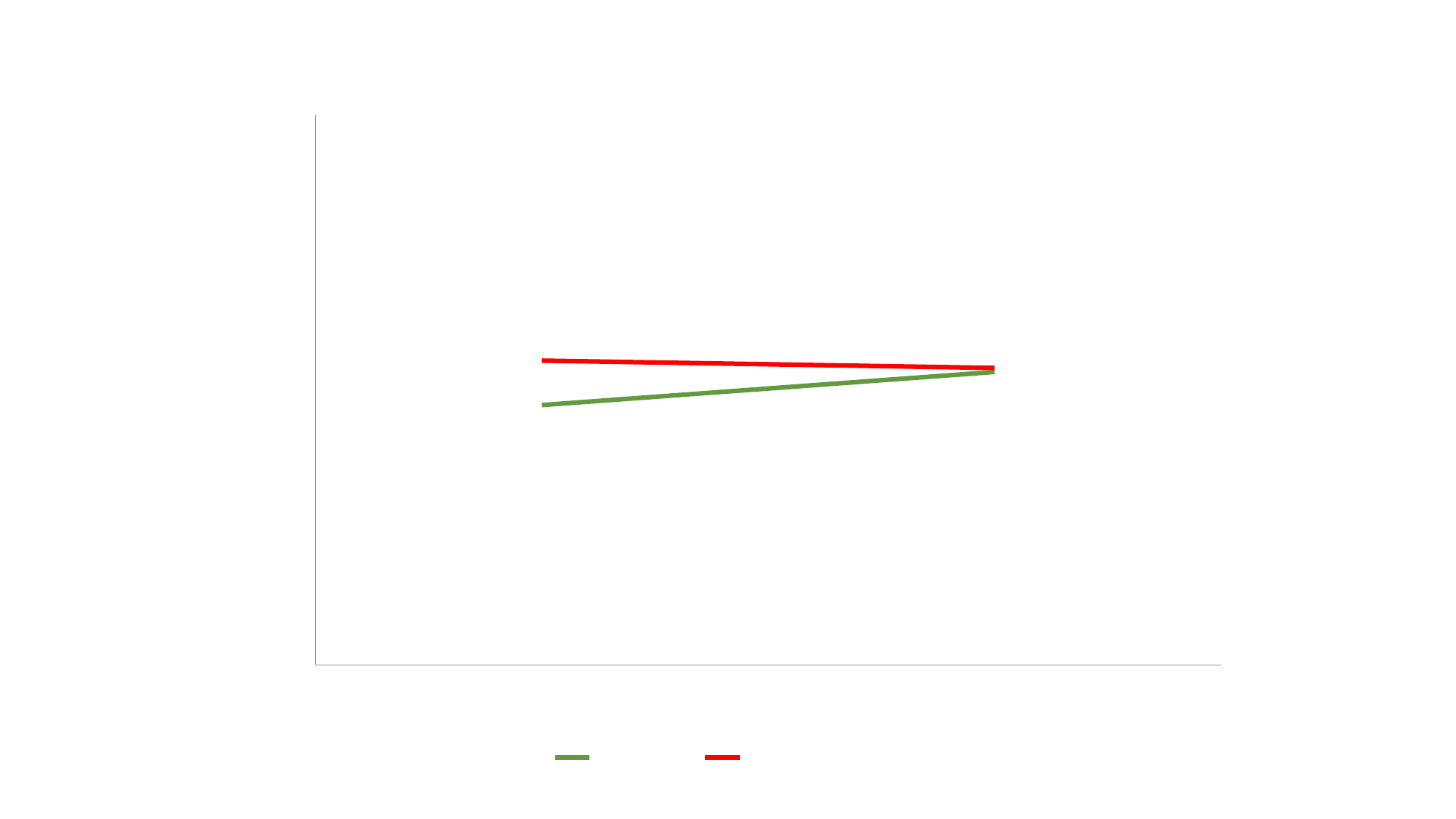
Does the green line rise or fall from left to right? rise How many lines are plotted on the chart? 2 Where is the legend positioned relative to the plot area? below the plot area What colours are the two lines on the chart? green and red Does the red line rise or fall from left to right? fall How many series does the legend list? 2 At the left end of the lines, which is higher, the green line or the red line? the red line What kind of chart is shown on the slide? line chart How many data points does the green line have? 2